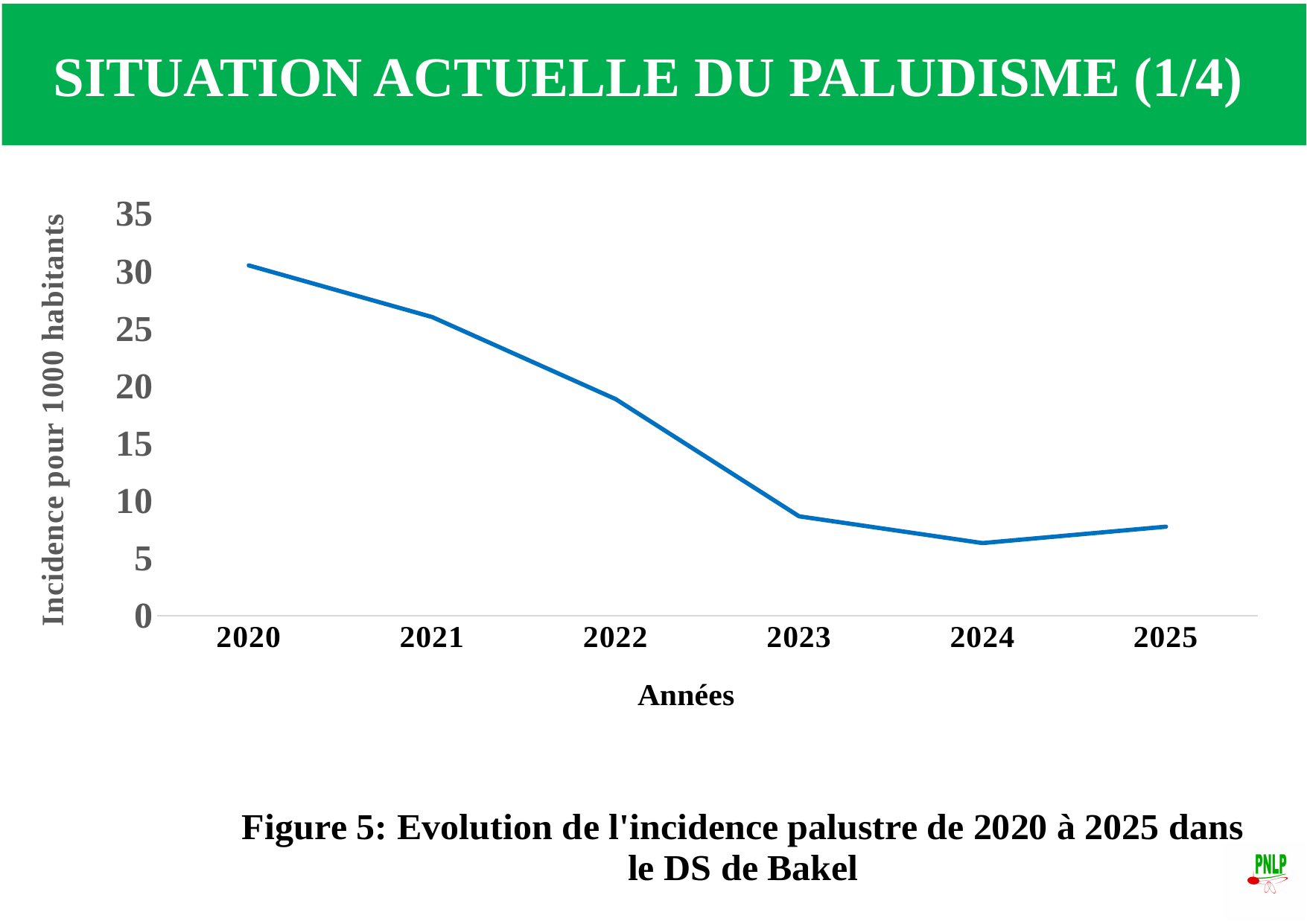
Is the incidence for 2024 greater or less than 10? less What is the label of the x axis? Années What is the label of the y axis? Incidence pour 1000 habitants Is the incidence for 2022 greater or less than 15? greater What kind of chart is shown on the slide? line chart Is the incidence for 2021 greater or less than 30? less Which year has the highest incidence? 2020 Which year has the higher incidence, 2020 or 2025? 2020 Which year has the lowest incidence? 2024 How many years are plotted on the x axis? 6 Does the incidence generally rise or fall from 2020 to 2024? fall